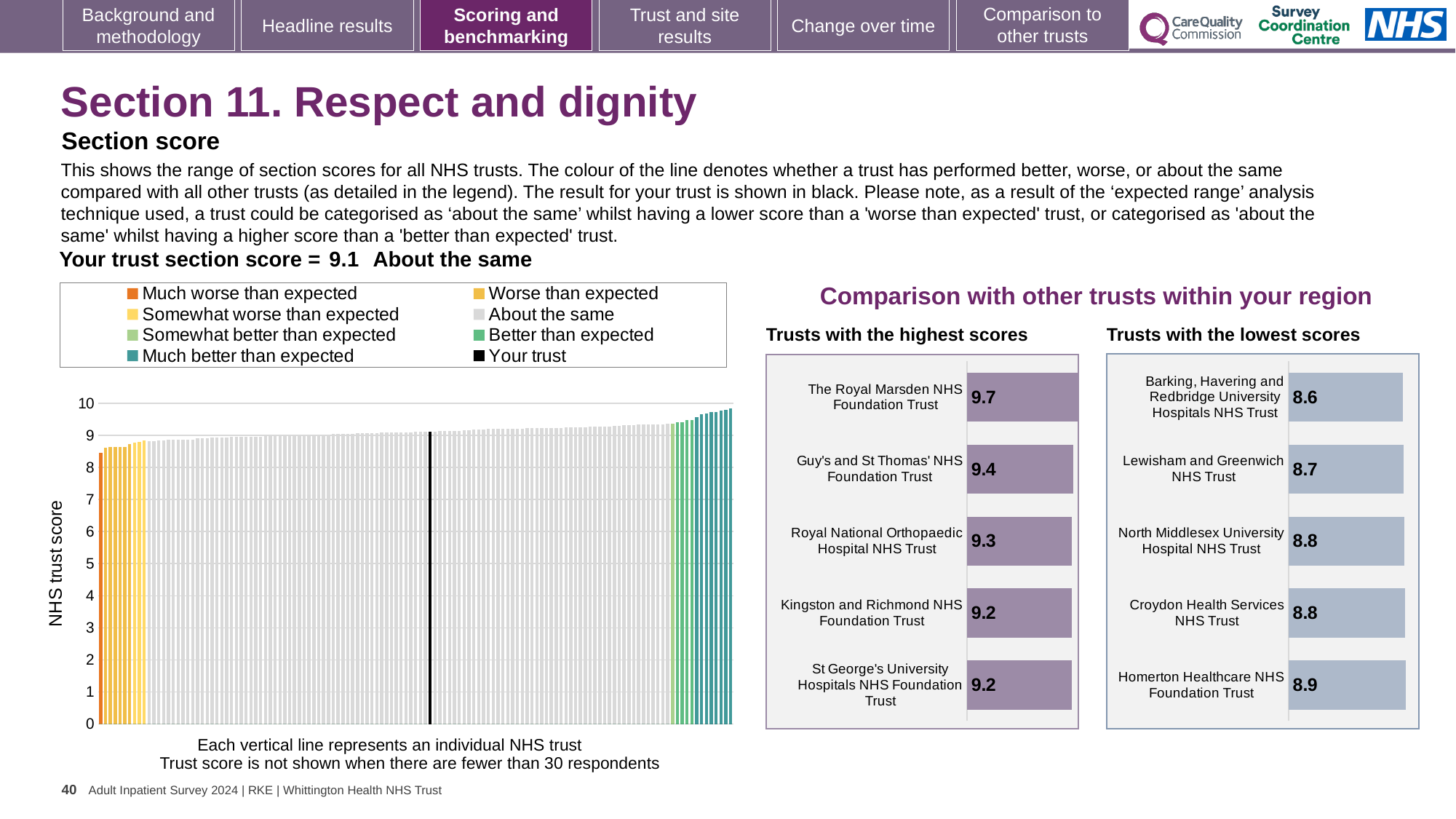
In the 'Trusts with the lowest scores' chart, which trust has the lowest score? Barking, Havering and Redbridge University Hospitals NHS Trust In the 'Trusts with the highest scores' chart, which trust has the highest score? The Royal Marsden NHS Foundation Trust In the 'Trusts with the lowest scores' chart, what is the score for Lewisham and Greenwich NHS Trust? 8.7 In the 'Trusts with the highest scores' chart, what is the difference between the scores of The Royal Marsden NHS Foundation Trust and Guy's and St Thomas' NHS Foundation Trust? 0.3 In the main chart on the left showing all NHS trusts, what is the section score for your trust (the black bar)? 9.1 How many trusts are shown in the 'Trusts with the lowest scores' chart? 5 In the 'Trusts with the lowest scores' chart, which has the larger score: Lewisham and Greenwich NHS Trust or Homerton Healthcare NHS Foundation Trust? Homerton Healthcare NHS Foundation Trust In the main chart on the left showing all NHS trusts, do the bar values rise or fall from left to right? rise In the 'Trusts with the highest scores' chart, what is the score for Royal National Orthopaedic Hospital NHS Trust? 9.3 What kind of chart is the main chart on the left showing all NHS trusts? bar chart How many entries does the legend of the main chart on the left list? 8 In the 'Trusts with the highest scores' chart, what is the score for The Royal Marsden NHS Foundation Trust? 9.7